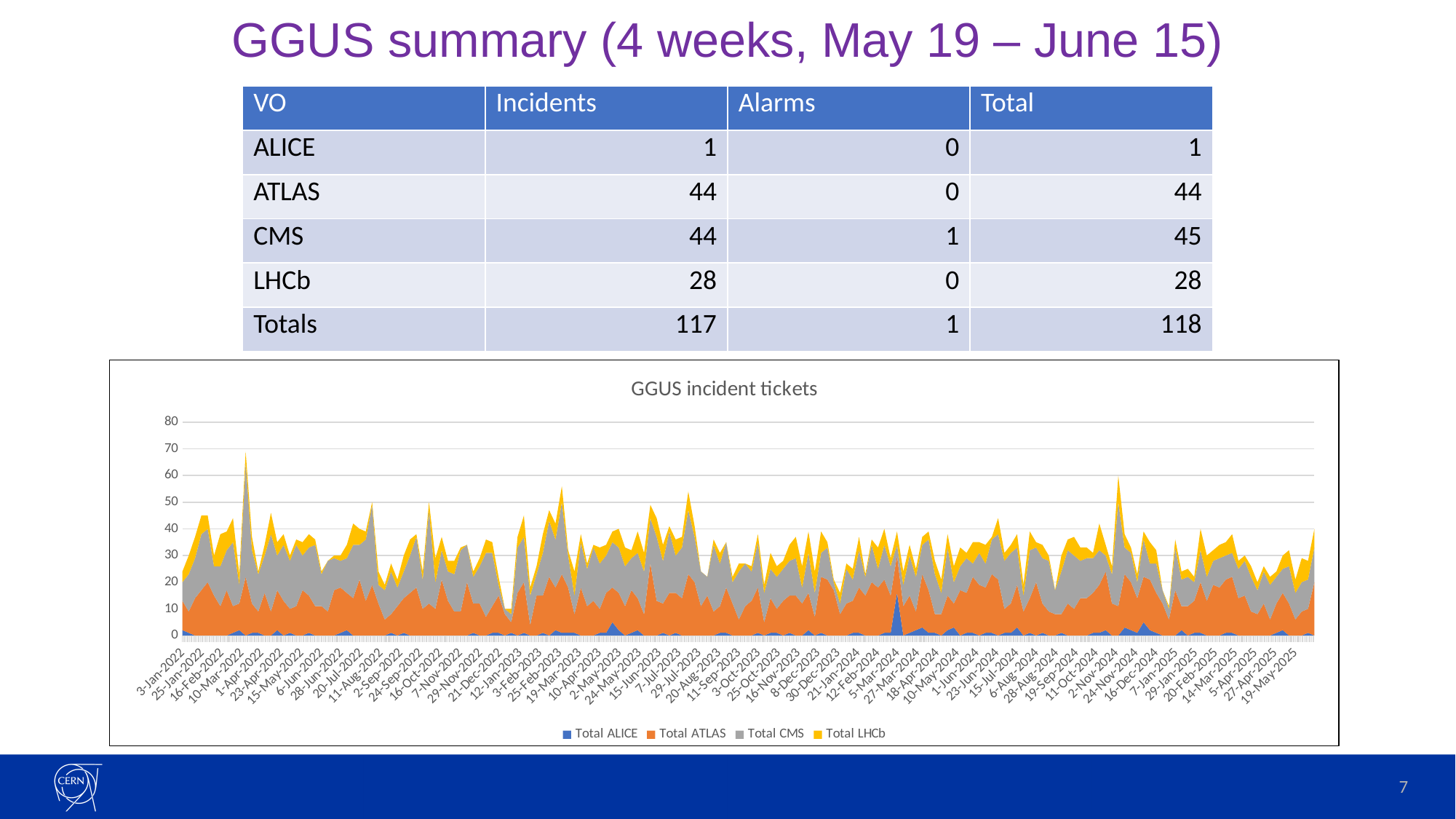
In the 'GGUS incident tickets' chart, is the stacked total at the peak near 1-Apr-2022 greater or less than 60? greater What is the title of the chart on the slide? GGUS incident tickets In the 'GGUS incident tickets' chart, is the stacked total at the peak near 1-Apr-2022 greater or less than 80? less Which colour represents the 'Total LHCb' series in the 'GGUS incident tickets' chart? yellow In the 'GGUS incident tickets' chart, is the stacked total at the peak near 2-Nov-2024 greater or less than 50? greater What kind of chart is the 'GGUS incident tickets' chart? stacked area chart How many series does the legend of the 'GGUS incident tickets' chart list? 4